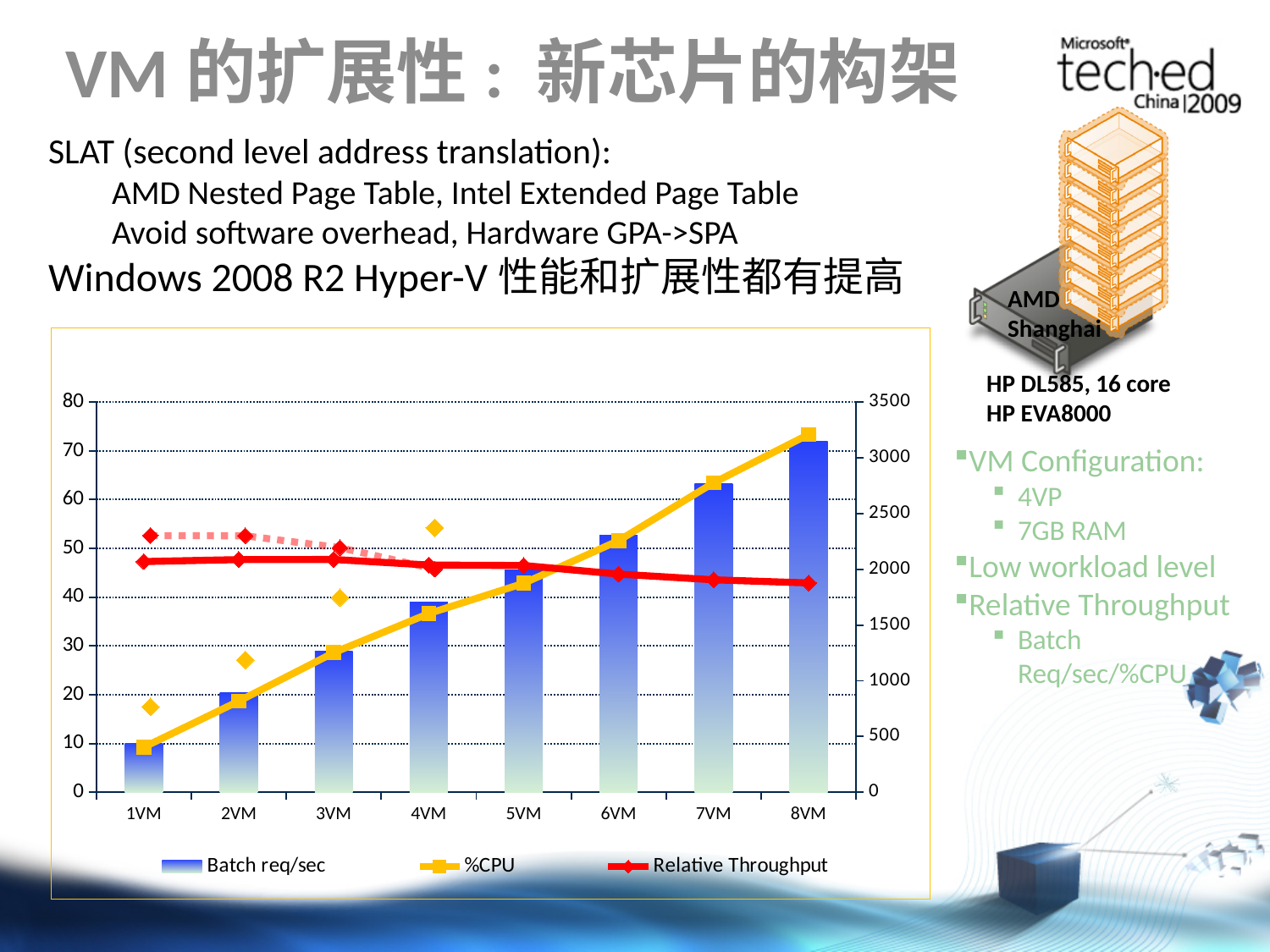
Do the Batch req/sec bars rise or fall as the number of VMs increases from 1VM to 8VM? Rise What is the maximum value shown on the right-hand axis of the chart? 3500 Which series are listed in the chart legend? Batch req/sec, %CPU, Relative Throughput At which VM count is the Batch req/sec bar the highest? 8VM Which has the higher %CPU value, 1VM or 8VM? 8VM At which VM count is the Batch req/sec bar the lowest? 1VM How many series does the chart legend list? 3 How many VM categories are shown along the x axis of the chart? 8 Does the Relative Throughput line rise or fall from 1VM to 8VM? Fall Which has the larger Batch req/sec bar, 3VM or 7VM? 7VM What kind of chart is shown on the slide? A combination bar and line chart